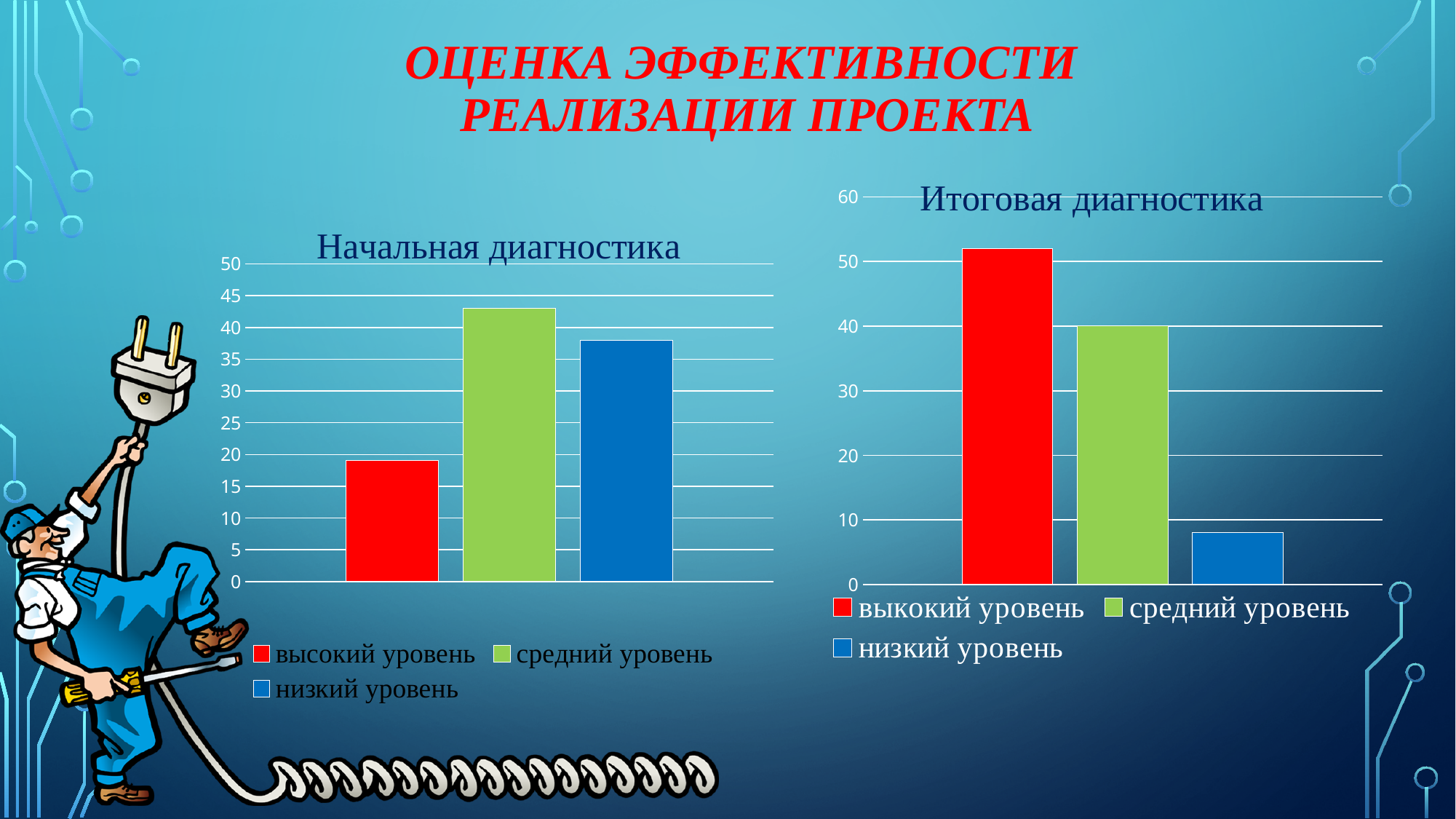
In the "Итоговая диагностика" chart on the right, is the value for выкокий уровень greater or less than 50? greater In the "Итоговая диагностика" chart on the right, is the value for низкий уровень greater or less than 10? less In the "Начальная диагностика" chart on the left, is the value for высокий уровень greater or less than 20? less In the "Начальная диагностика" chart on the left, which series has the lowest bar? высокий уровень What colour is the bar for низкий уровень in the "Итоговая диагностика" chart on the right? blue How many series does the legend of the "Начальная диагностика" chart on the left list? 3 What kind of chart is the "Начальная диагностика" chart on the left? bar chart In the "Итоговая диагностика" chart on the right, which series has the lowest bar? низкий уровень In the "Итоговая диагностика" chart on the right, which is larger: the bar for средний уровень or the bar for низкий уровень? средний уровень In the "Итоговая диагностика" chart on the right, which series has the highest bar? выкокий уровень In the "Начальная диагностика" chart on the left, which series has the highest bar? средний уровень